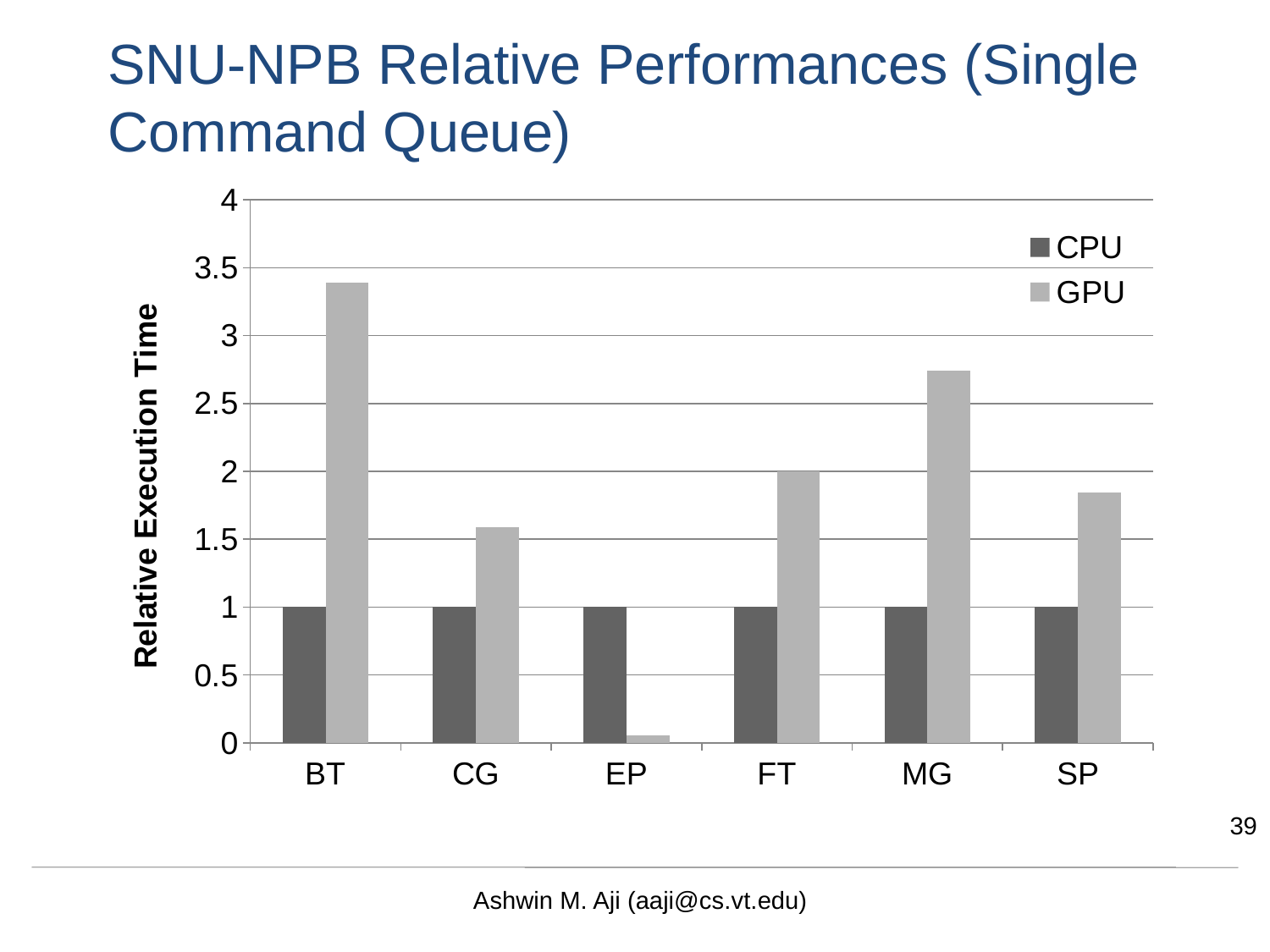
Is the GPU value for BT greater or less than 3? greater How many benchmark categories are shown on the x axis? 6 What is the CPU relative execution time for MG? 1 How many series does the legend list? 2 What kind of chart is shown on the slide? bar chart Is the GPU value for EP greater or less than 0.5? less Is the GPU value for MG greater or less than 2.5? greater Which is larger, the GPU value for CG or the GPU value for SP? SP Which benchmark has the lowest GPU relative execution time? EP What is the label of the y axis? Relative Execution Time Which benchmark has the highest GPU relative execution time? BT What is the CPU relative execution time for BT? 1